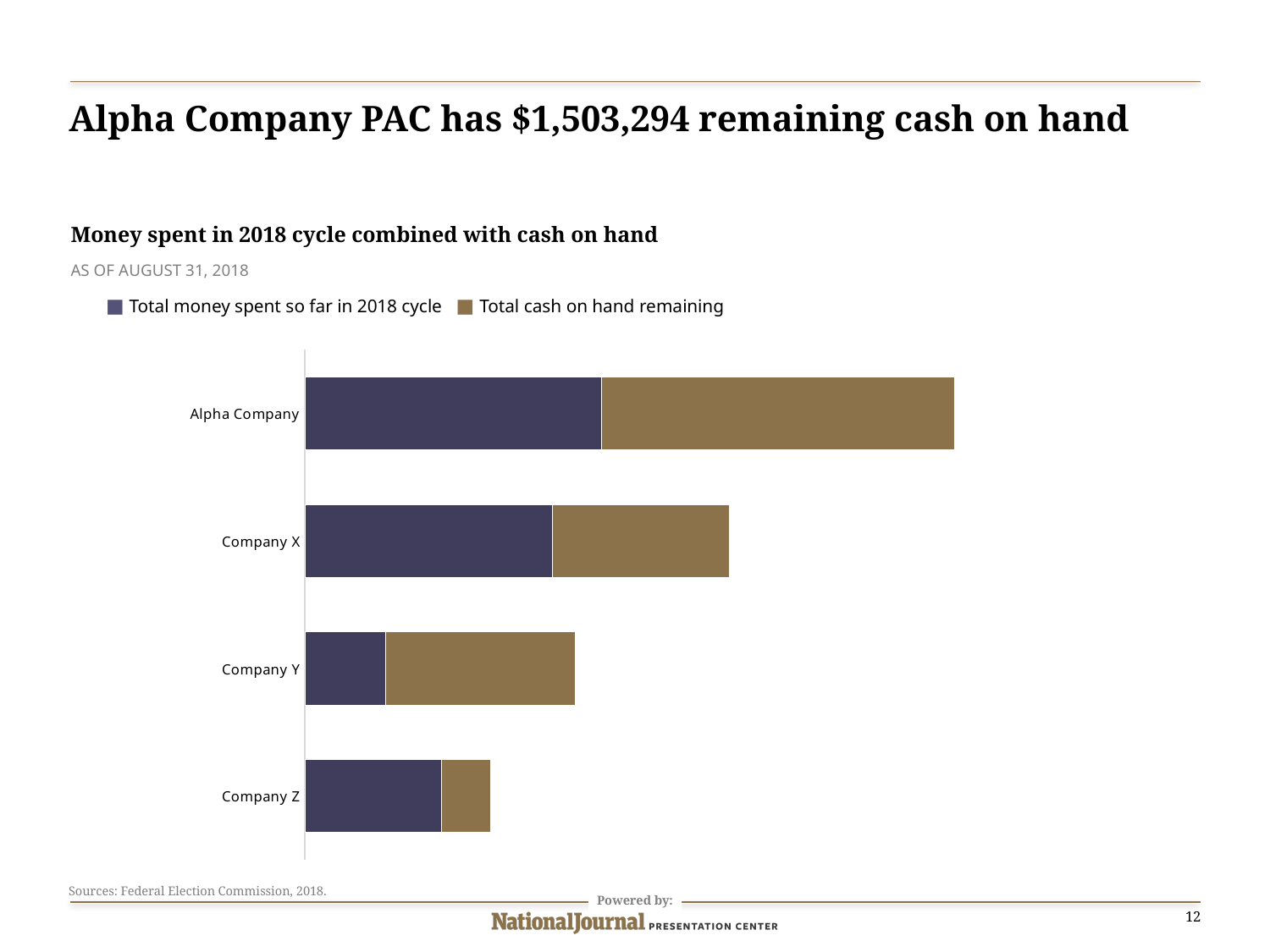
For Company Y, which is larger: total money spent so far in 2018 cycle or total cash on hand remaining? Total cash on hand remaining Which company has the smallest 'Total cash on hand remaining' segment? Company Z According to the slide, how much remaining cash on hand does Alpha Company PAC have? $1,503,294 For Company Z, which is larger: total money spent so far in 2018 cycle or total cash on hand remaining? Total money spent so far in 2018 cycle How many series does the legend list? 2 How many companies are shown in the chart? 4 What kind of chart is shown on the slide? bar chart Which company has the largest 'Total money spent so far in 2018 cycle' segment? Alpha Company Which company has the smallest 'Total money spent so far in 2018 cycle' segment? Company Y Which company has the longest total bar (money spent plus cash on hand)? Alpha Company What is the chart's subtitle describing what is plotted? Money spent in 2018 cycle combined with cash on hand Which company has the shortest total bar (money spent plus cash on hand)? Company Z